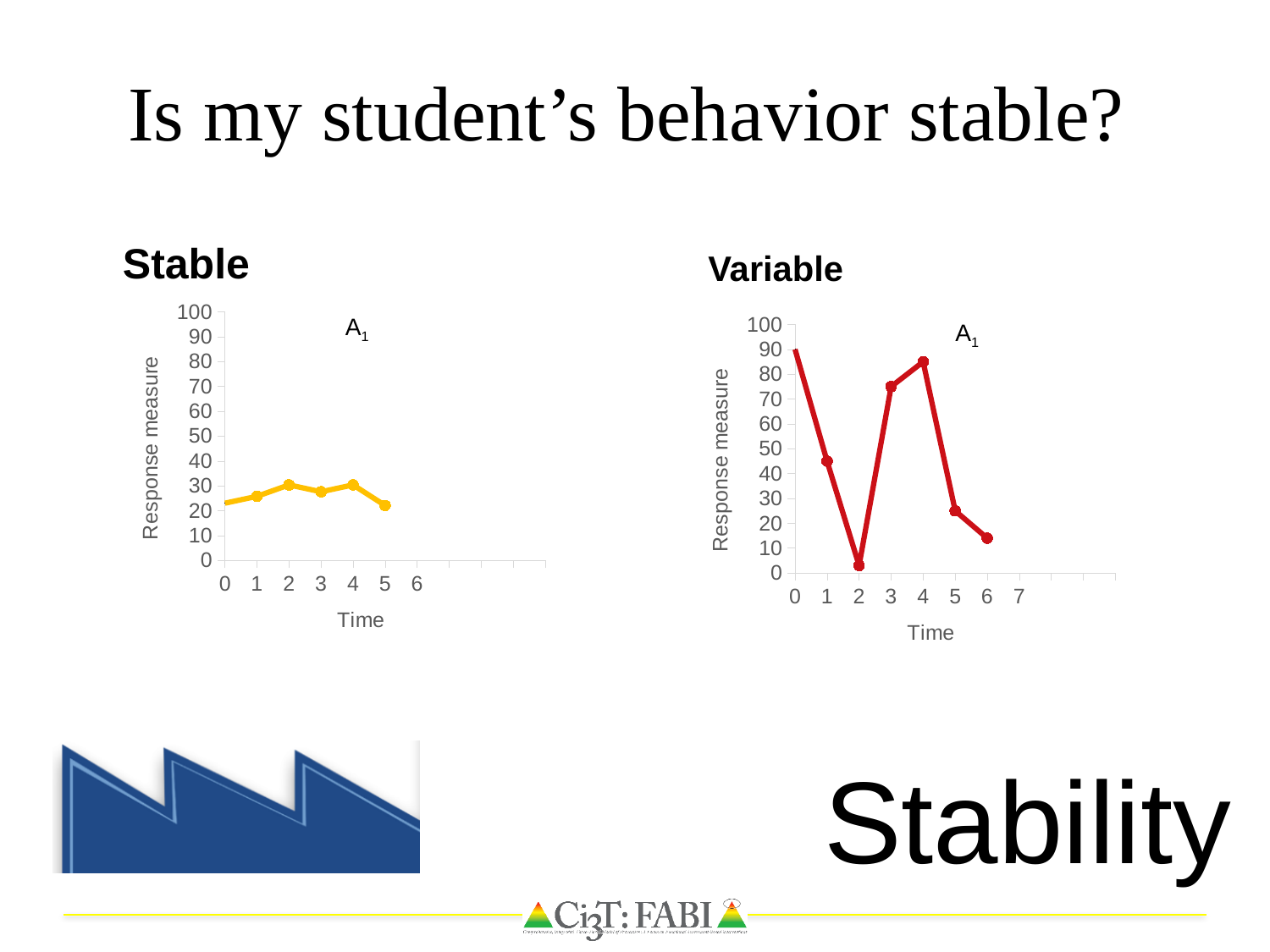
On the 'Stable' chart, which is larger: the value at time 2 or the value at time 5? time 2 On the 'Variable' chart, is the value at time 0 greater or less than 80? greater On the 'Variable' chart, do the values rise or fall from time 4 to time 6? fall What kind of chart is the 'Stable' chart on the left? line chart How many data points are plotted on the 'Stable' chart? 6 On the 'Variable' chart, which is larger: the value at time 1 or the value at time 3? time 3 What is the label on the y axis of the 'Stable' chart? Response measure What kind of chart is the 'Variable' chart on the right? line chart How many data points are plotted on the 'Variable' chart? 7 On the 'Variable' chart, is the value at time 2 greater or less than 10? less On the 'Variable' chart, at which time is the response measure lowest? 2 On the 'Stable' chart, is the value at time 4 greater or less than 40? less